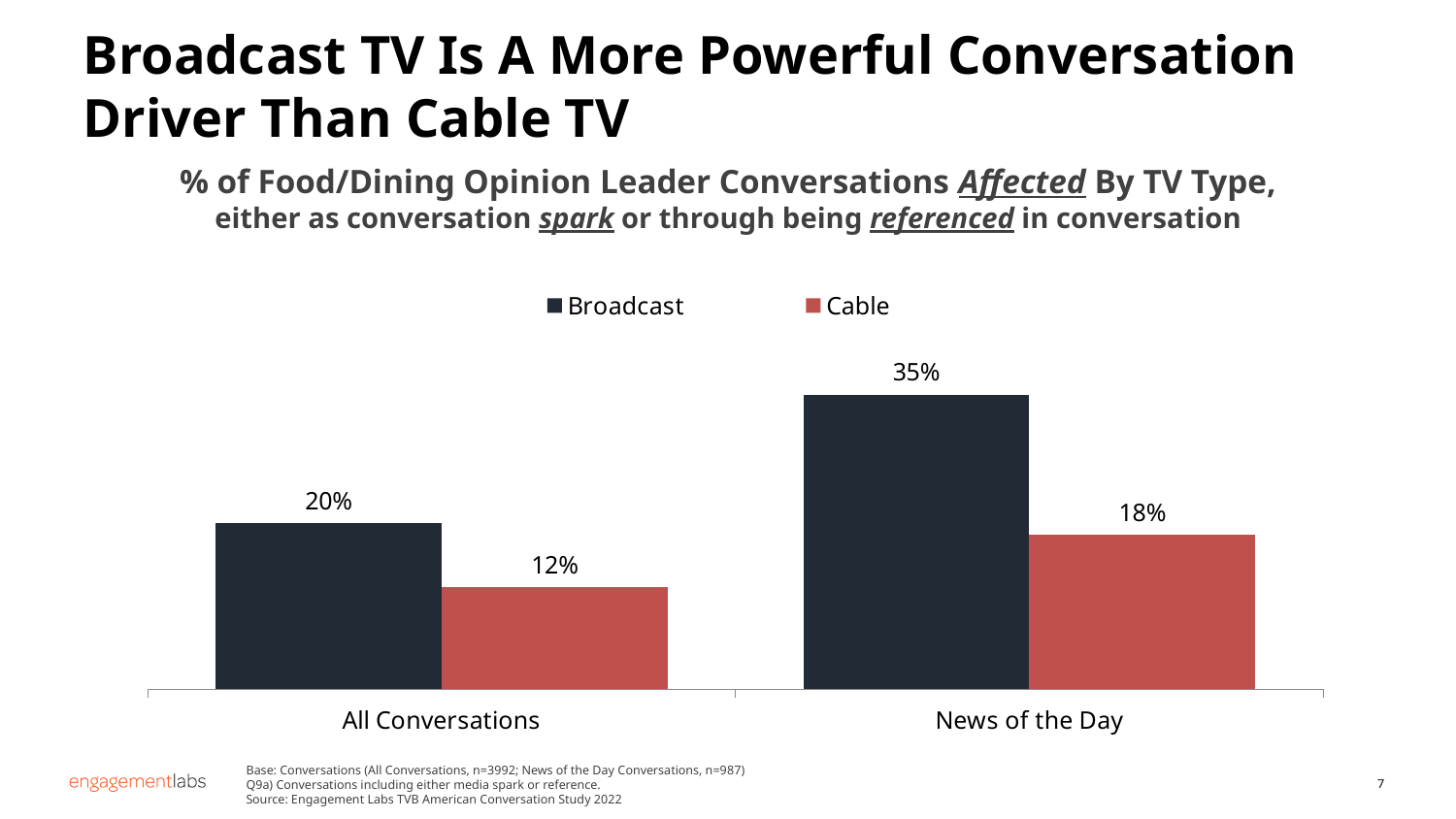
Which is larger: the Cable value for News of the Day or the Broadcast value for All Conversations? Broadcast value for All Conversations What is the Cable value for News of the Day? 18% How many categories are shown on the x axis? 2 How many series does the legend list? 2 What is the Broadcast value for All Conversations? 20% What is the difference between the Broadcast and Cable values for News of the Day? 17% What is the difference between the Broadcast values for News of the Day and All Conversations? 15% What is the Cable value for All Conversations? 12% Which series has the lowest value in the All Conversations category? Cable What kind of chart is shown on the slide? Bar chart Which colour represents the Cable series in the legend? Red Which category has the highest Broadcast value? News of the Day